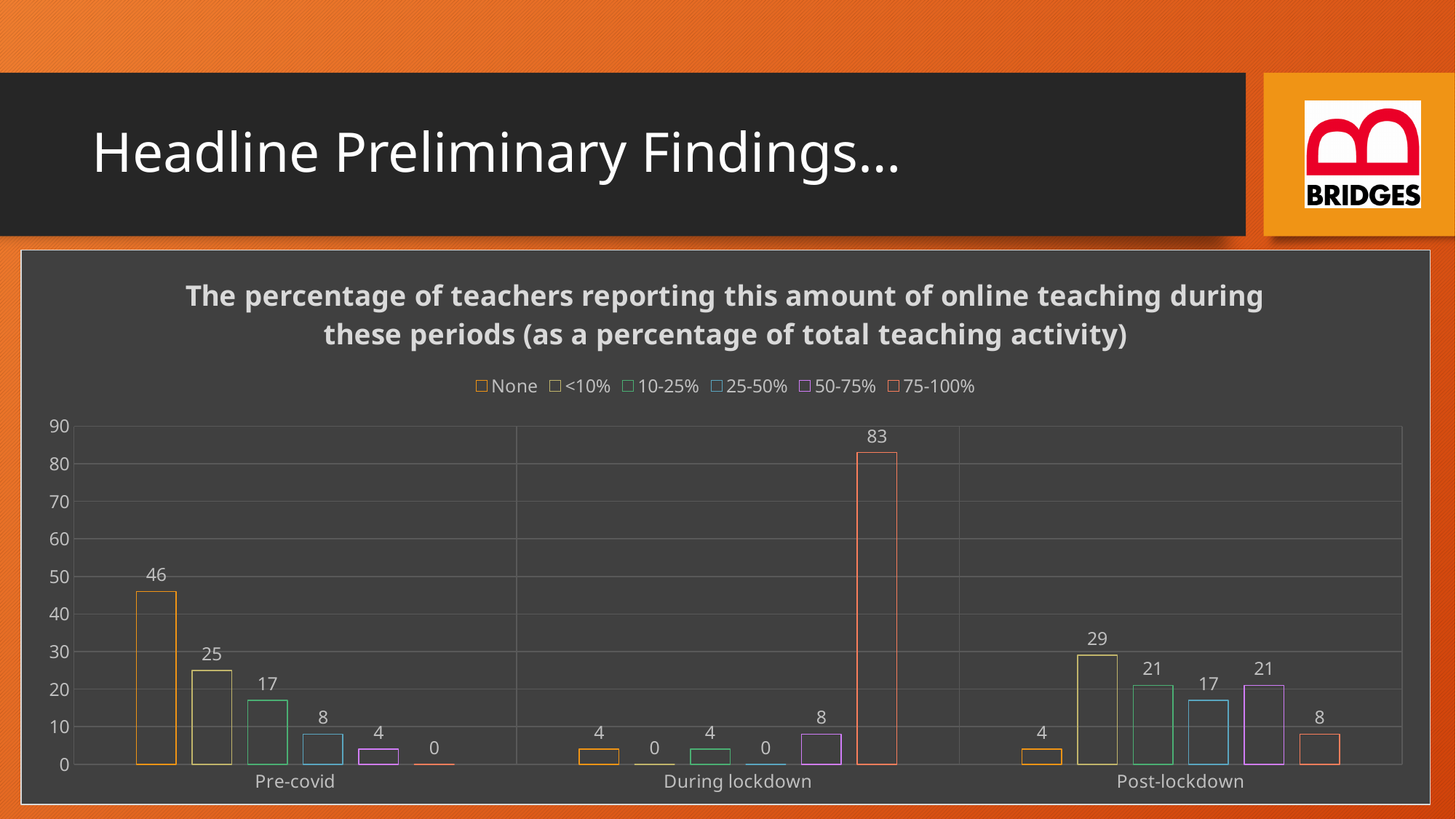
How many period categories are shown on the x axis? 3 What is the title of the chart? The percentage of teachers reporting this amount of online teaching during these periods (as a percentage of total teaching activity) Which is larger: the '10-25%' value in Pre-covid or the '10-25%' value in Post-lockdown? Post-lockdown What is the difference between the 'None' value in Pre-covid and the 'None' value in Post-lockdown? 42 Which series has the highest value in the During lockdown period? 75-100% Which series has the lowest value in the Pre-covid period? 75-100% Is the value for '75-100%' during lockdown greater or less than 80? greater How many series does the legend list? 6 What is the value for the '75-100%' series during lockdown? 83 What type of chart is shown on the slide? Bar chart What is the value for the '<10%' series in the Post-lockdown period? 29 What is the value for the 'None' series in the Pre-covid period? 46